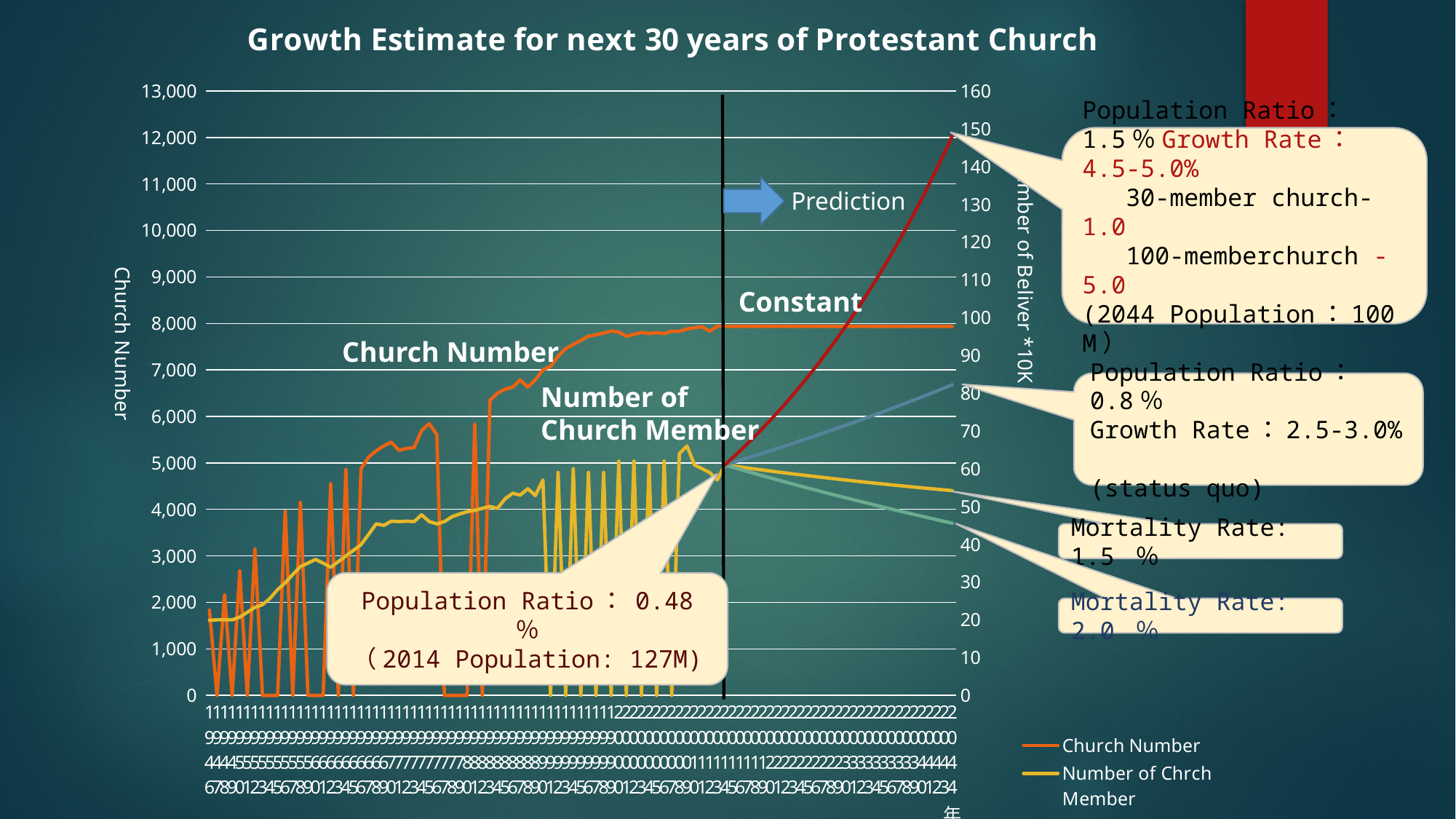
On the right axis, is the end value of the red prediction line (Growth Rate 4.5-5.0%) greater or less than 140? greater How many series does the chart legend list? 2 Is the Church Number value in the prediction period (the 'Constant' line) greater or less than 9,000? less What is the title of the chart? Growth Estimate for next 30 years of Protestant Church Does the Church Number series generally rise or fall from 1946 to 2014? rise On the right axis, is the end value of the light blue prediction line (Growth Rate 2.5-3.0%) greater or less than 70? greater What kind of chart is shown on the slide? line chart What is the highest tick value shown on the right vertical axis? 160 What is the highest tick value shown on the left vertical axis? 13,000 What is the label of the left vertical axis? Church Number